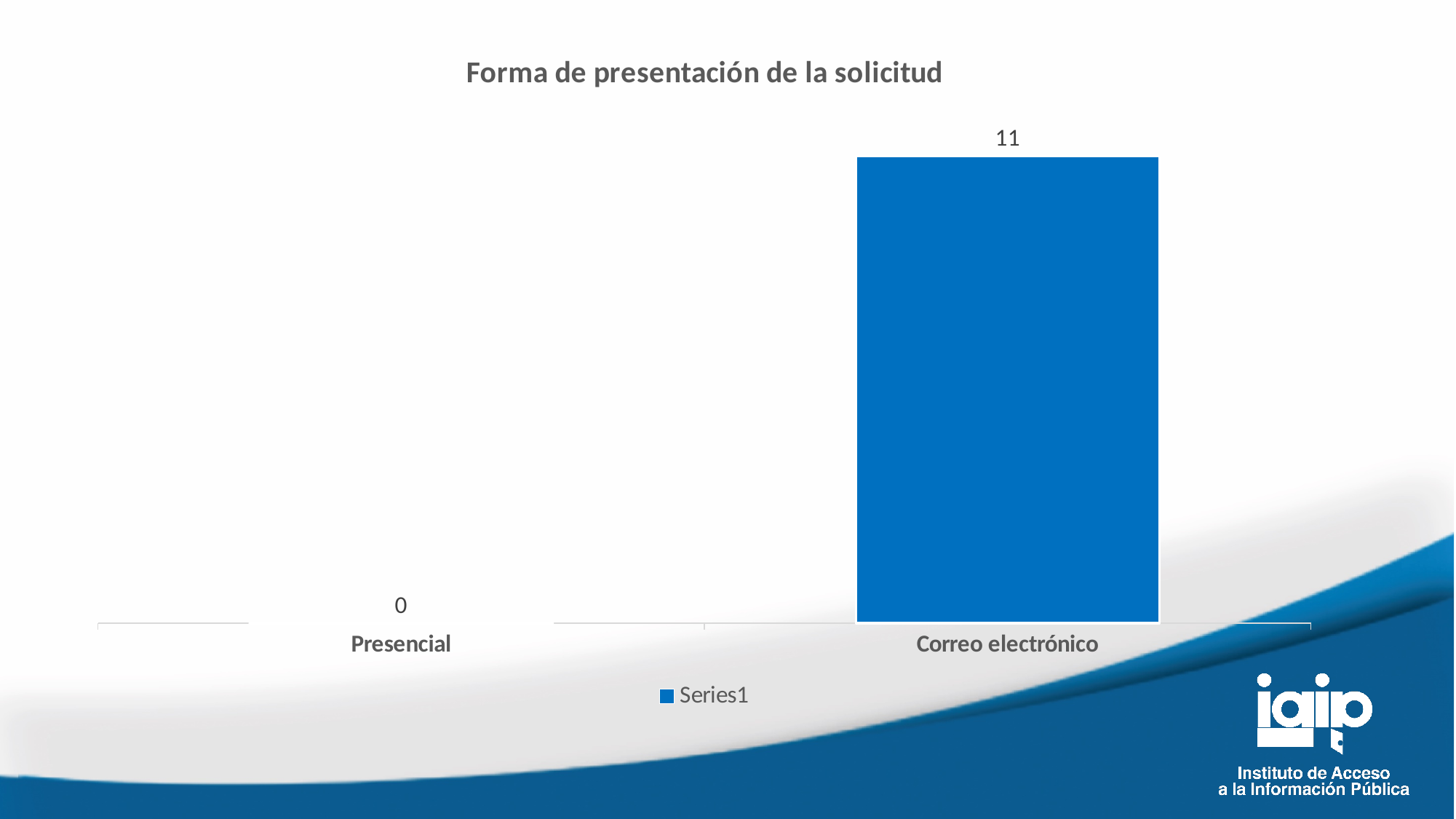
What is the value for Presencial? 0 Which is larger, the value for Presencial or the value for Correo electrónico? Correo electrónico What kind of chart is shown on the slide? Bar chart Do the values rise or fall from Presencial to Correo electrónico? Rise Which category has the lowest value? Presencial How many categories are shown on the x axis? 2 What is the difference between the values for Correo electrónico and Presencial? 11 What is the value for Correo electrónico? 11 What is the name of the series listed in the legend? Series1 How many series does the legend list? 1 What is the title of the chart? Forma de presentación de la solicitud Which category has the highest value? Correo electrónico